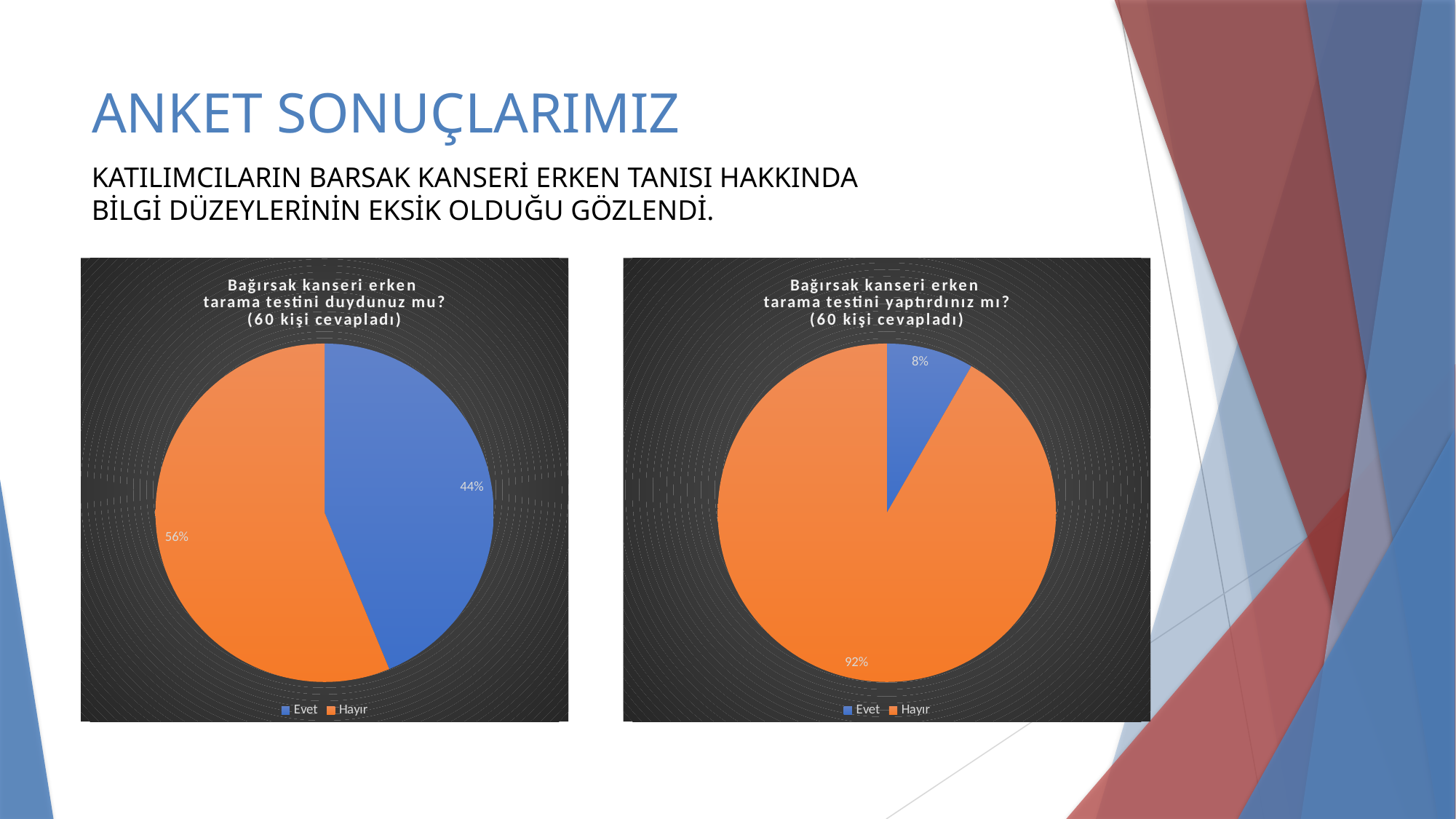
In the right pie chart, which answer has the smallest slice? Evet In the left pie chart, which answer has the larger slice, Evet or Hayır? Hayır In the right pie chart ("Bağırsak kanseri erken tarama testini yaptırdınız mı?"), what share of respondents answered Evet? 8% According to the title of the left pie chart, how many people answered the question? 60 kişi In the right pie chart ("Bağırsak kanseri erken tarama testini yaptırdınız mı?"), what share of respondents answered Hayır? 92% How many categories does the legend of the right pie chart list? 2 In the right pie chart, which colour represents Hayır? Orange What type of chart is the left chart on the slide? Pie chart In the left pie chart ("Bağırsak kanseri erken tarama testini duydunuz mu?"), what share of respondents answered Evet? 44% In the right pie chart, what is the difference in percentage points between the Hayır and Evet slices? 84 In the left pie chart, what is the difference in percentage points between the Hayır and Evet slices? 12